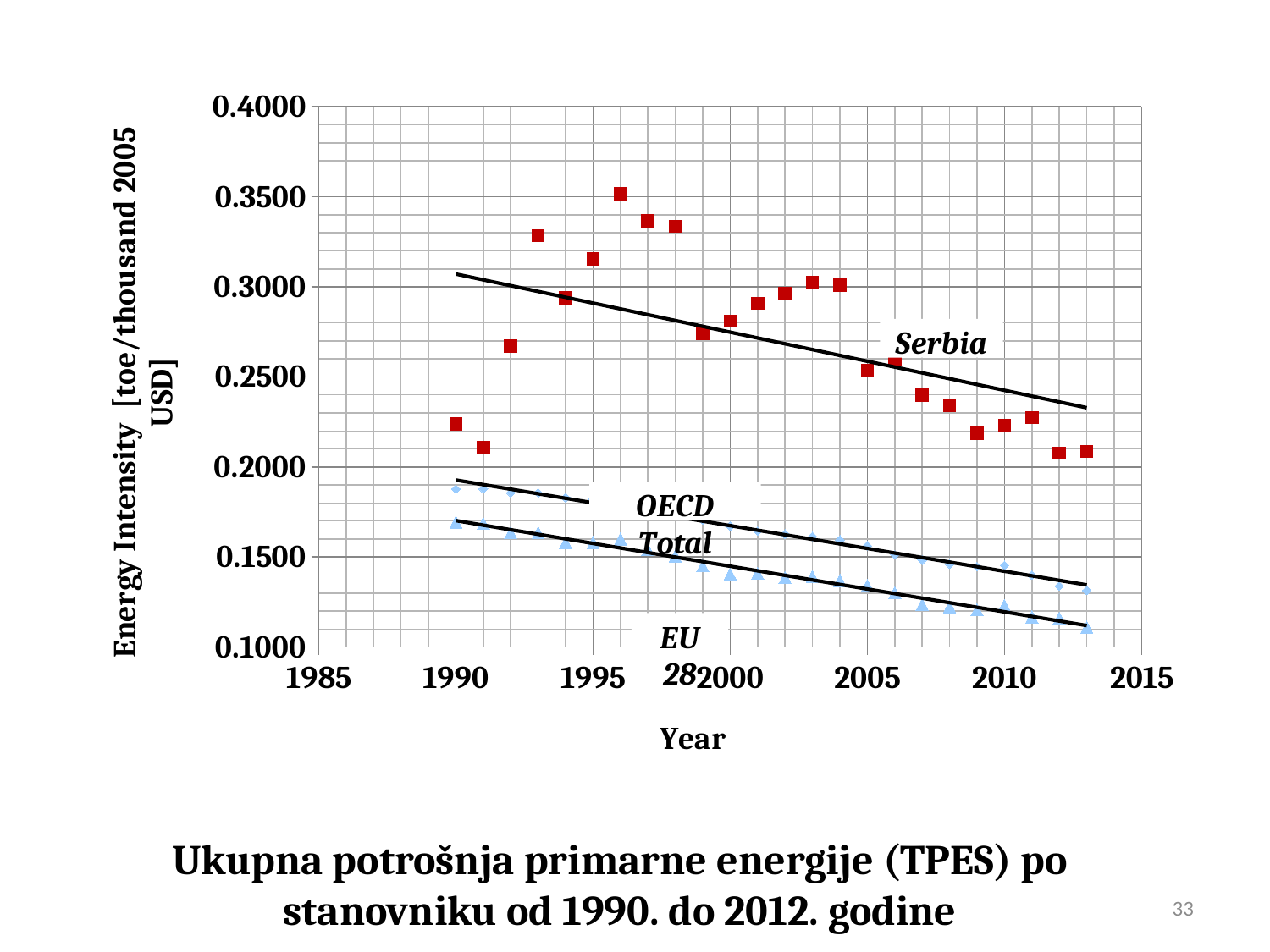
Do the EU values generally rise or fall from 1990 to 2013? fall In 2005, which series has the larger value, OECD Total or EU? OECD Total What kind of chart is shown on the slide? scatter chart Which series has the highest energy intensity values on the chart? Serbia Is the value for Serbia in 1990 greater or less than 0.2500? less Is the value for EU in 2013 greater or less than 0.1500? less How many data series are labelled on the chart? 3 In which year does the Serbia series reach its highest value? 1996 Is the value for Serbia in 1996 greater or less than 0.3000? greater What is the title of the vertical axis? Energy Intensity [toe/thousand 2005 USD] Which series has the lowest energy intensity values on the chart? EU